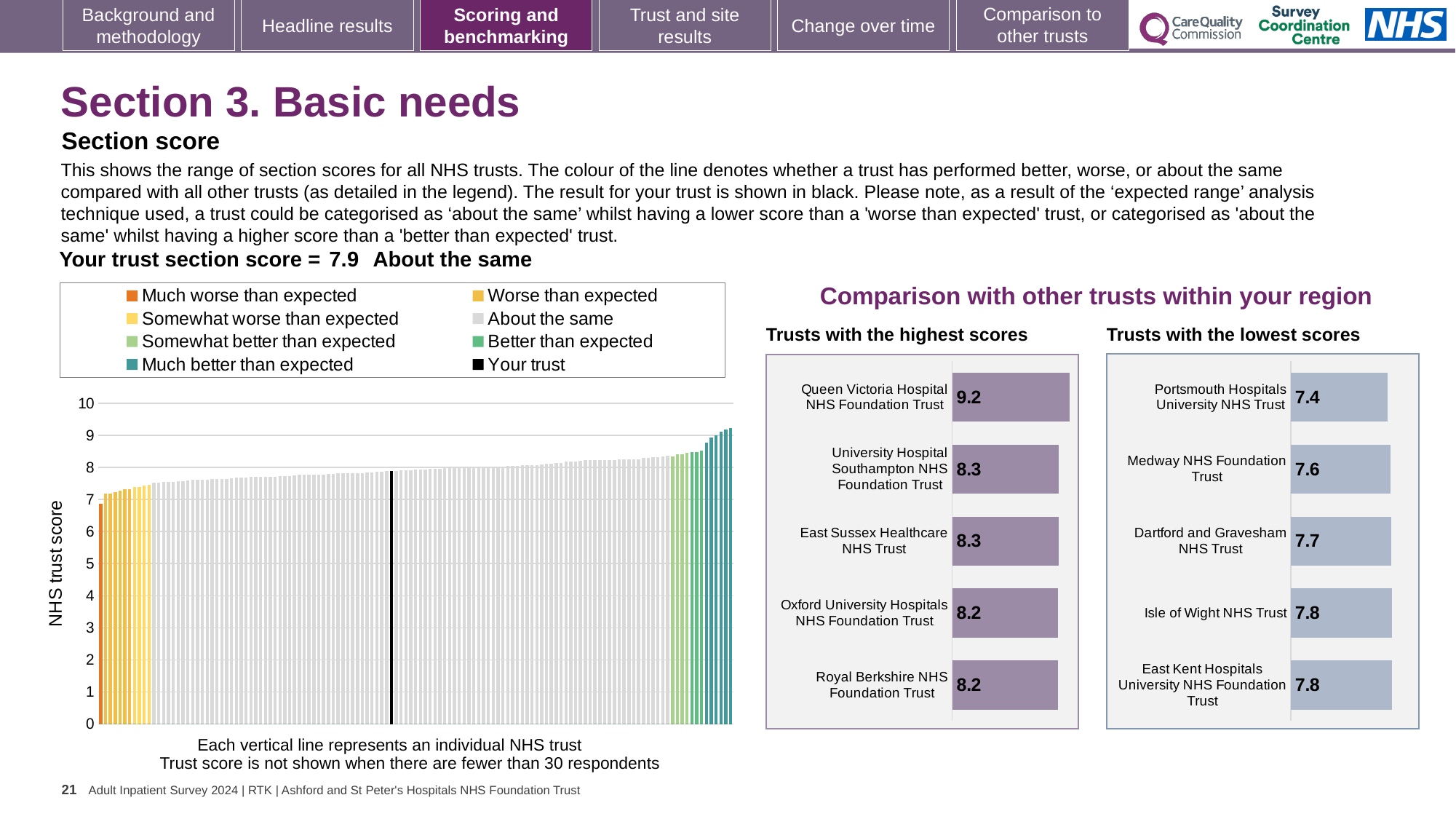
In the 'Trusts with the lowest scores' chart, what is the difference between the scores of East Kent Hospitals University NHS Foundation Trust and Portsmouth Hospitals University NHS Trust? 0.4 In the 'Trusts with the highest scores' chart, what is the score for Queen Victoria Hospital NHS Foundation Trust? 9.2 In the large chart on the left, is the value for the black 'Your trust' bar greater or less than 5? greater In the 'Trusts with the highest scores' chart, which trust has the highest score? Queen Victoria Hospital NHS Foundation Trust What kind of chart is the large chart on the left showing NHS trust scores? Bar chart How many entries does the legend of the large chart on the left list? 8 In the 'Trusts with the highest scores' chart, what is the difference between the scores of Queen Victoria Hospital NHS Foundation Trust and Royal Berkshire NHS Foundation Trust? 1.0 In the 'Trusts with the lowest scores' chart, what is the score for Medway NHS Foundation Trust? 7.6 In the 'Trusts with the lowest scores' chart, which has the larger score: Dartford and Gravesham NHS Trust or Isle of Wight NHS Trust? Isle of Wight NHS Trust In the 'Trusts with the lowest scores' chart, which trust has the lowest score? Portsmouth Hospitals University NHS Trust How many trusts are shown in the 'Trusts with the highest scores' chart? 5 What is the y-axis label of the large chart on the left? NHS trust score